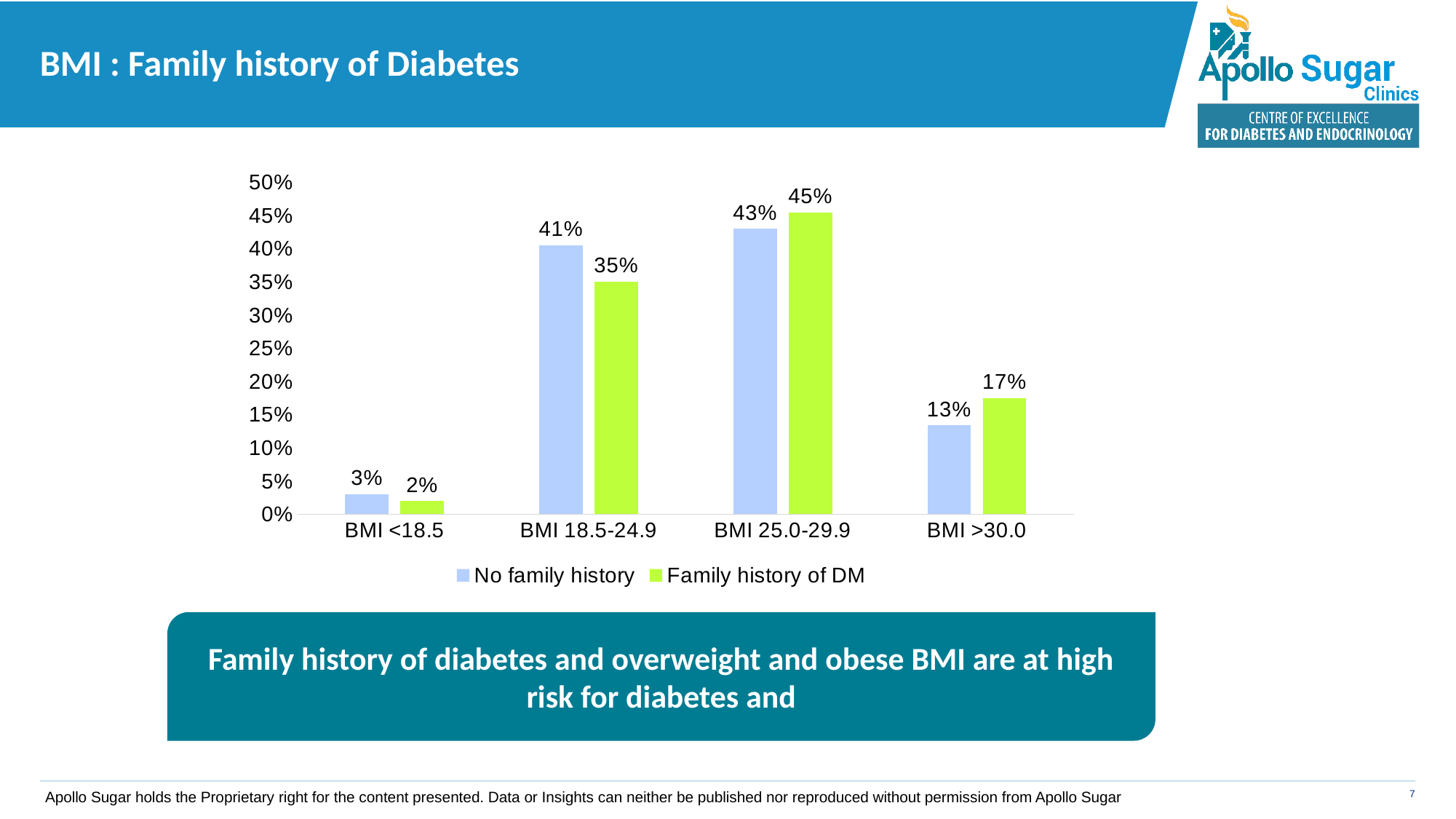
What is the value for No family history in the BMI 18.5-24.9 category? 41% Which BMI category has the lowest value for No family history? BMI <18.5 What is the value for Family history of DM in the BMI >30.0 category? 17% What kind of chart is shown on the slide? Bar chart What is the value for Family history of DM in the BMI <18.5 category? 2% Which BMI category has the highest value for Family history of DM? BMI 25.0-29.9 How many series does the legend list? 2 In the BMI >30.0 category, which series has the larger value, No family history or Family history of DM? Family history of DM How many BMI categories are shown on the x axis? 4 What is the difference between No family history and Family history of DM in the BMI 18.5-24.9 category? 6% What is the difference between the Family history of DM values for BMI 25.0-29.9 and BMI >30.0? 28% Which colour represents the Family history of DM series in the legend? Green